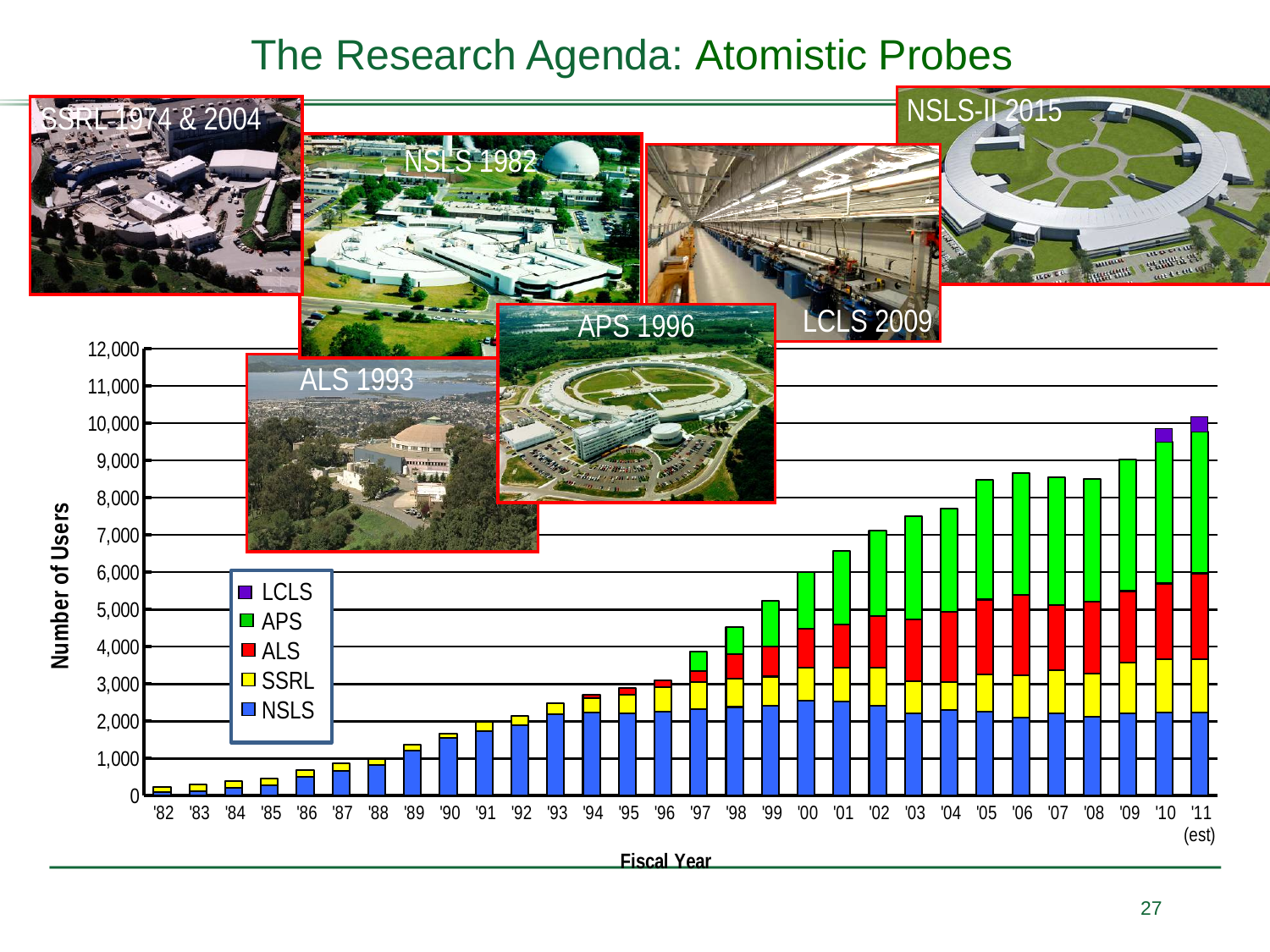
How many fiscal years are shown along the x axis of the chart? 30 Do the total number of users generally rise or fall from '82 to '11? rise Which fiscal year has the highest total number of users? '11 (est) Which fiscal year has the lowest total number of users? '82 Is the total number of users for '11 (est) greater or less than 9,000? greater How many series does the chart's legend list? 5 Is the total number of users for '05 greater or less than 8,000? greater Is the total number of users for '99 greater or less than 5,000? greater What kind of chart is shown on the slide? stacked bar chart Which fiscal year has a larger total number of users, '03 or '98? '03 What is the title of the chart's y axis? Number of Users